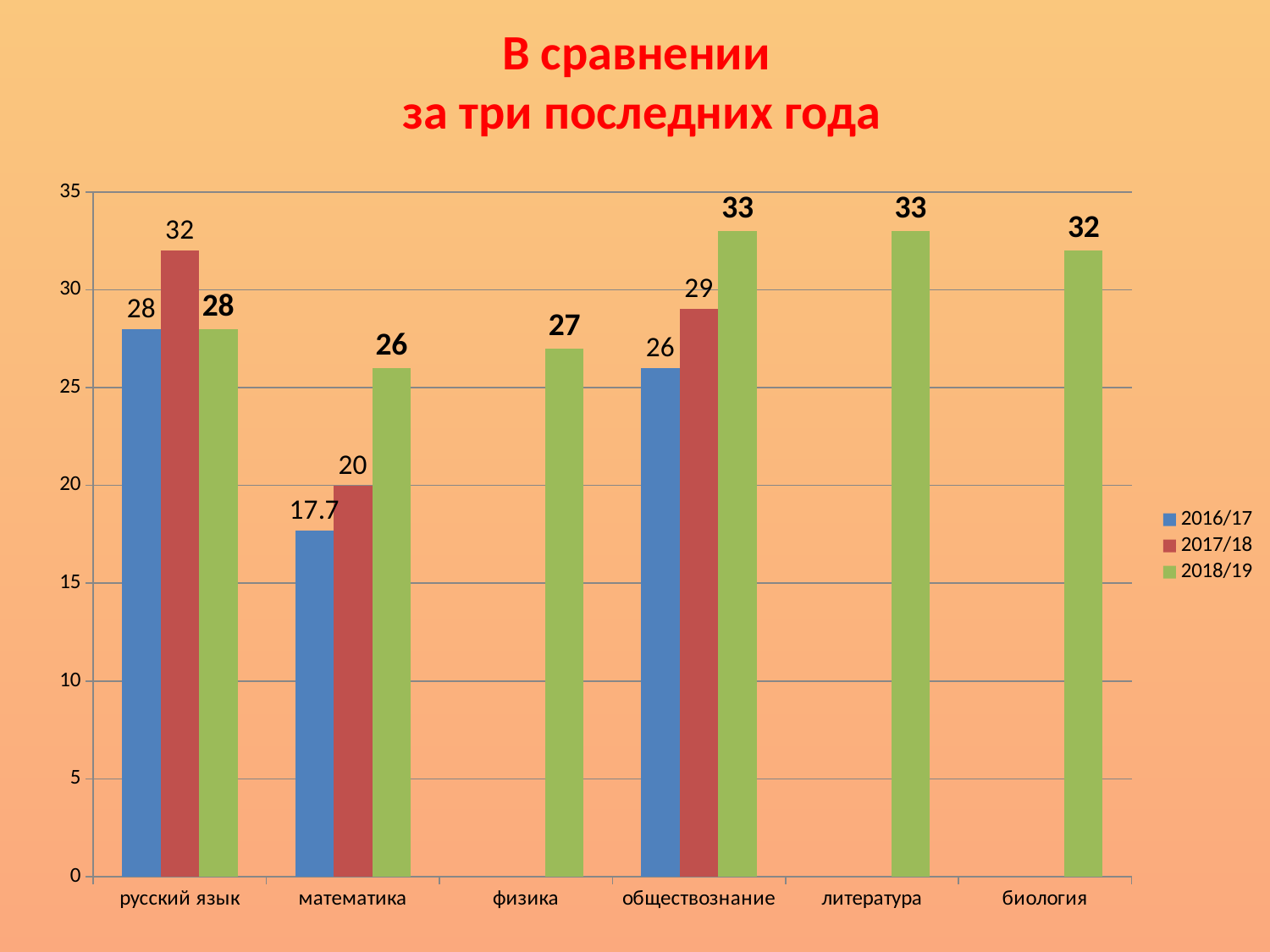
Do the values for математика rise or fall from 2016/17 to 2018/19? rise Which is larger for русский язык: the 2017/18 value or the 2018/19 value? 2017/18 Which category has the lowest value in the 2016/17 series? математика What kind of chart is shown on the slide? bar chart What is the value for русский язык in the 2017/18 series? 32 How many categories are shown on the x axis? 6 Which category has the lowest value in the 2018/19 series? математика What is the value for физика in the 2018/19 series? 27 What is the difference between the 2018/19 and 2016/17 values for обществознание? 7 How many series does the legend list? 3 What is the value for обществознание in the 2017/18 series? 29 What is the value for математика in the 2016/17 series? 17.7